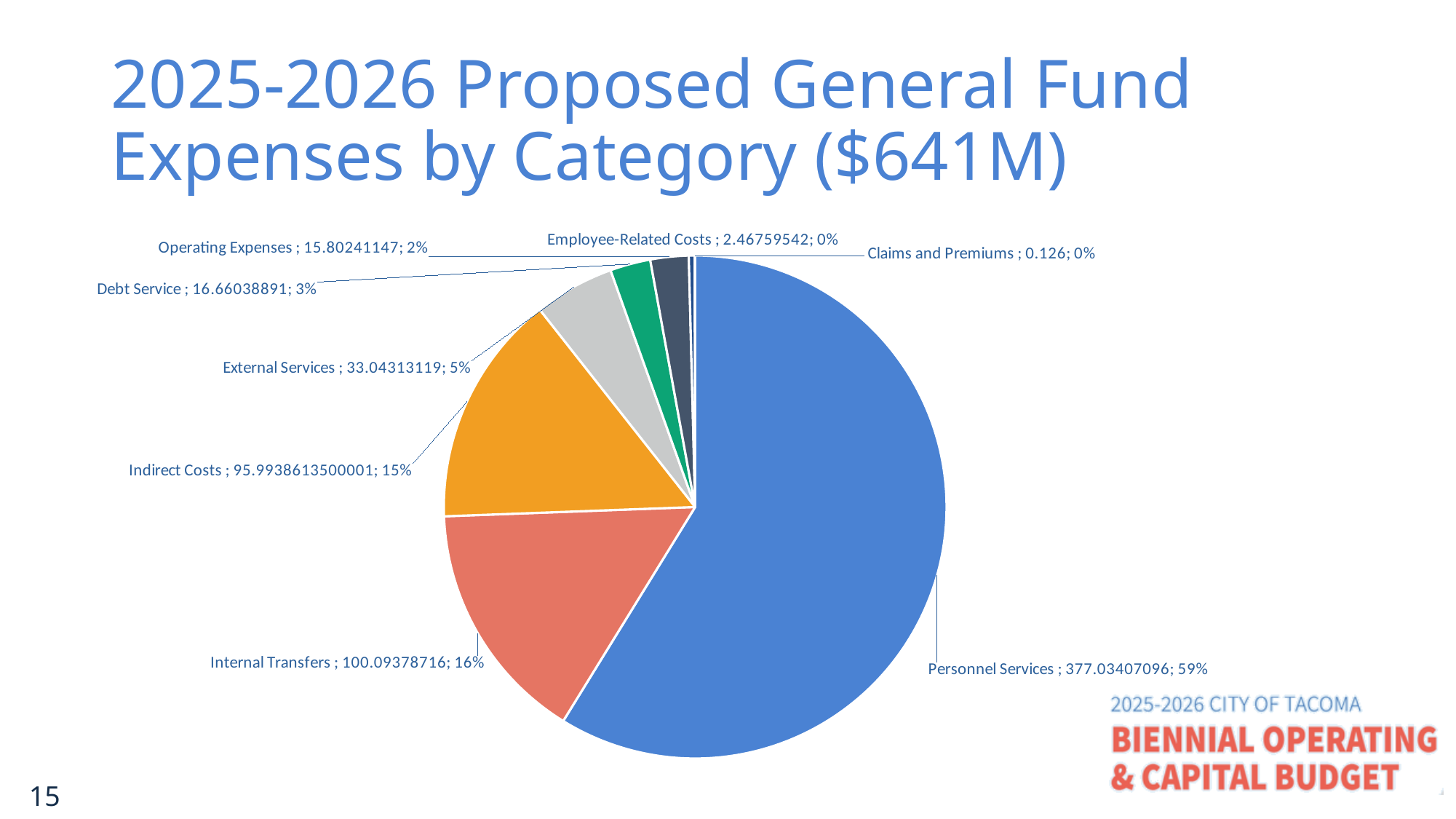
What kind of chart is shown on the slide? Pie chart What is the value for Debt Service? 16.66038891 What is the value for Personnel Services? 377.03407096 What is the difference in percentage share between Personnel Services and Internal Transfers? 43% What share of the pie does Internal Transfers represent? 16% What is the title of the slide? 2025-2026 Proposed General Fund Expenses by Category ($641M) What is the value for Indirect Costs? 95.9938613500001 How many categories does the pie chart show? 8 Which category has the largest slice of the pie? Personnel Services What share of the pie does External Services represent? 5% Which is larger, Internal Transfers or Indirect Costs? Internal Transfers Which category has the smallest value? Claims and Premiums